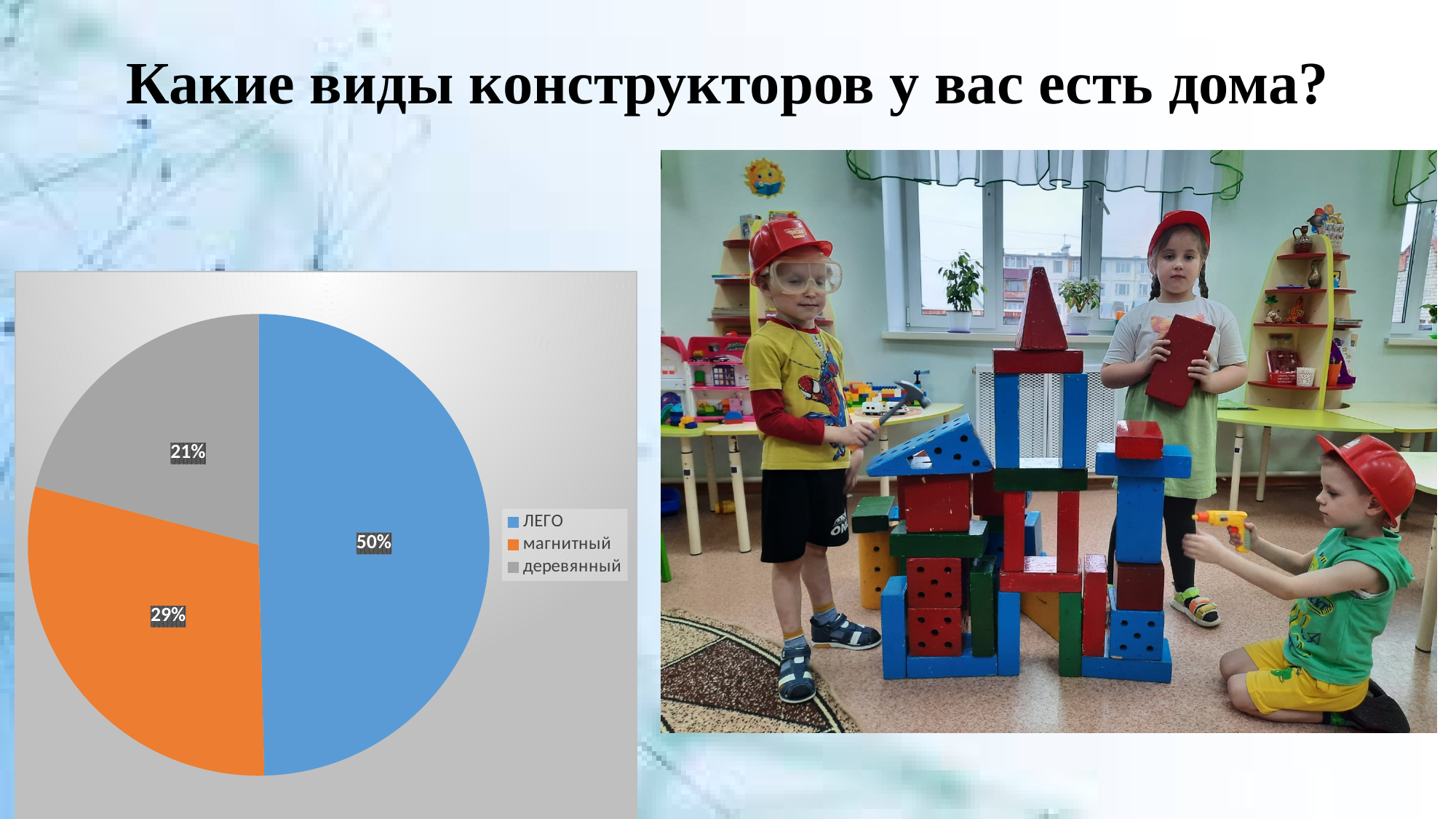
Which category has the smallest slice of the pie? деревянный What colour is the slice for ЛЕГО? blue How many entries does the legend list? 3 What is the difference in percentage points between ЛЕГО and магнитный? 21 What share of the pie does магнитный have? 29% How many slices does the pie chart have? 3 Which is larger, the share for магнитный or the share for деревянный? магнитный What share of the pie does деревянный have? 21% What is the difference in percentage points between магнитный and деревянный? 8 What kind of chart is shown on the slide? pie chart Which category has the largest slice of the pie? ЛЕГО What share of the pie does ЛЕГО have? 50%